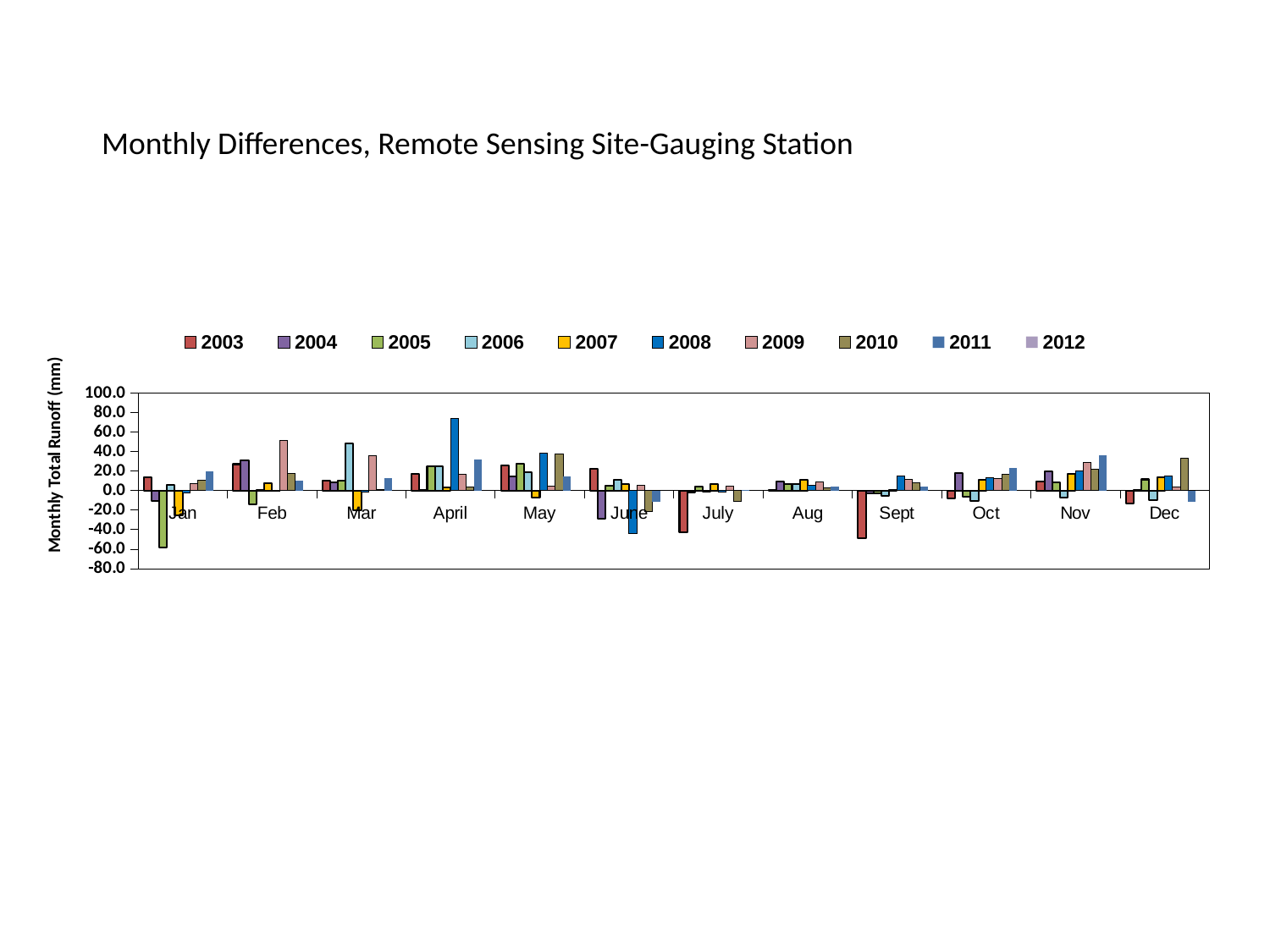
Is the value for 2005 in Jan greater or less than -40.0? less Is the value for 2009 in Feb greater or less than 40.0? greater What is the title of the chart? Monthly Differences, Remote Sensing Site-Gauging Station What kind of chart is shown on the slide? bar chart What is the label on the vertical axis? Monthly Total Runoff (mm) Which series has the lowest value in Sept? 2003 How many months are shown along the x axis? 12 How many series does the legend list? 10 Which series has the highest value in April? 2008 Is the value for 2008 in April greater or less than 60.0? greater Which is larger: the value for 2008 in April or the value for 2009 in Feb? 2008 in April